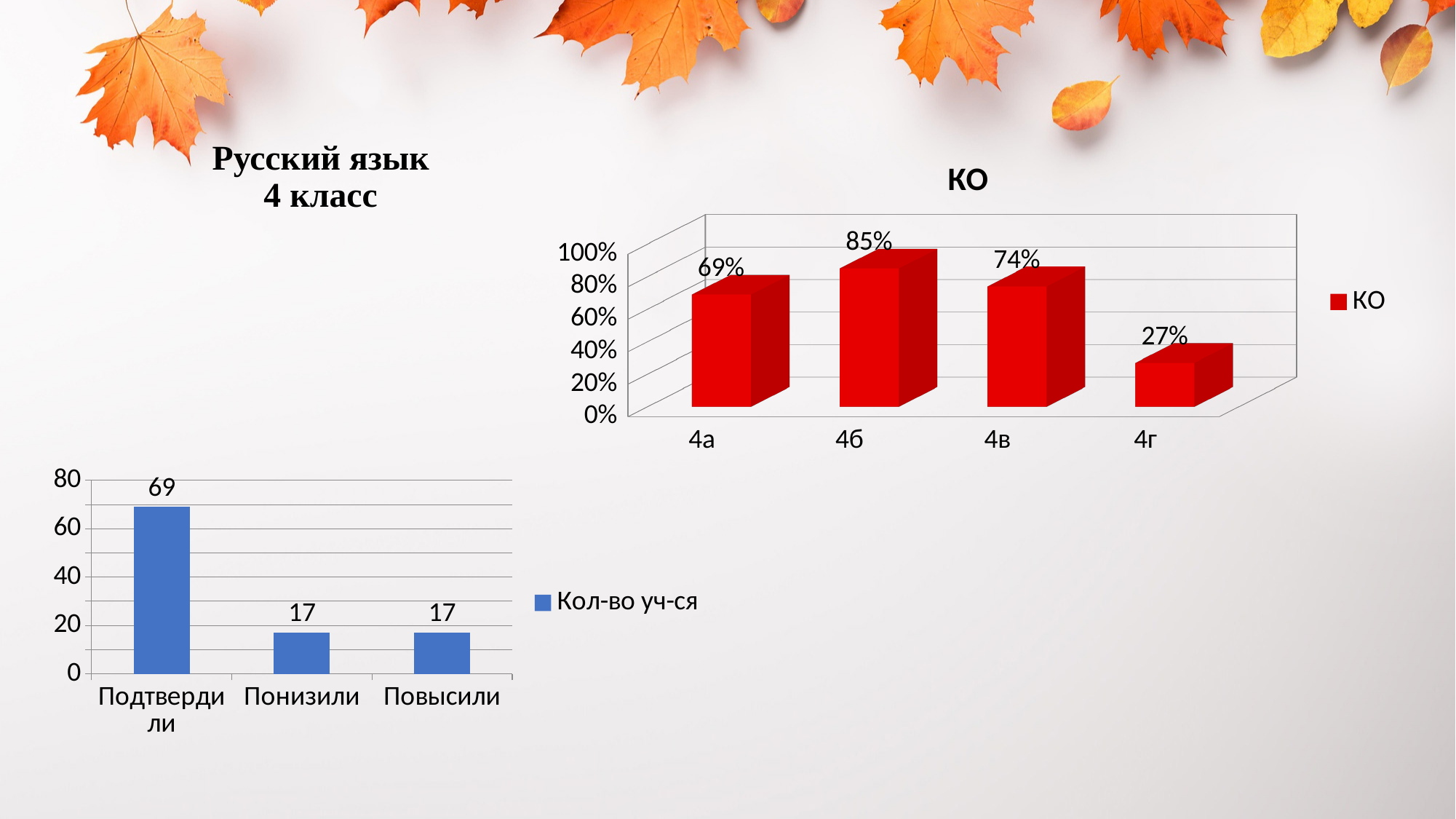
In the bottom-left chart, what is the difference between the values for Подтвердили and Понизили? 52 In the chart titled КО, which category has the lowest value? 4г In the chart titled КО, what is the value for 4б? 85% In the chart titled КО, which is larger, the value for 4а or the value for 4в? 4в In the bottom-left chart, what is the value for Подтвердили? 69 In the chart titled КО, how many categories are shown on the x axis? 4 In the bottom-left chart, what series name does the legend show? Кол-во уч-ся In the chart titled КО, what is the difference between the values for 4б and 4а? 16% In the bottom-left chart, which category has the highest value? Подтвердили In the chart titled КО, which category has the highest value? 4б What kind of chart is the bottom-left chart? bar chart In the chart titled КО, what is the value for 4г? 27%